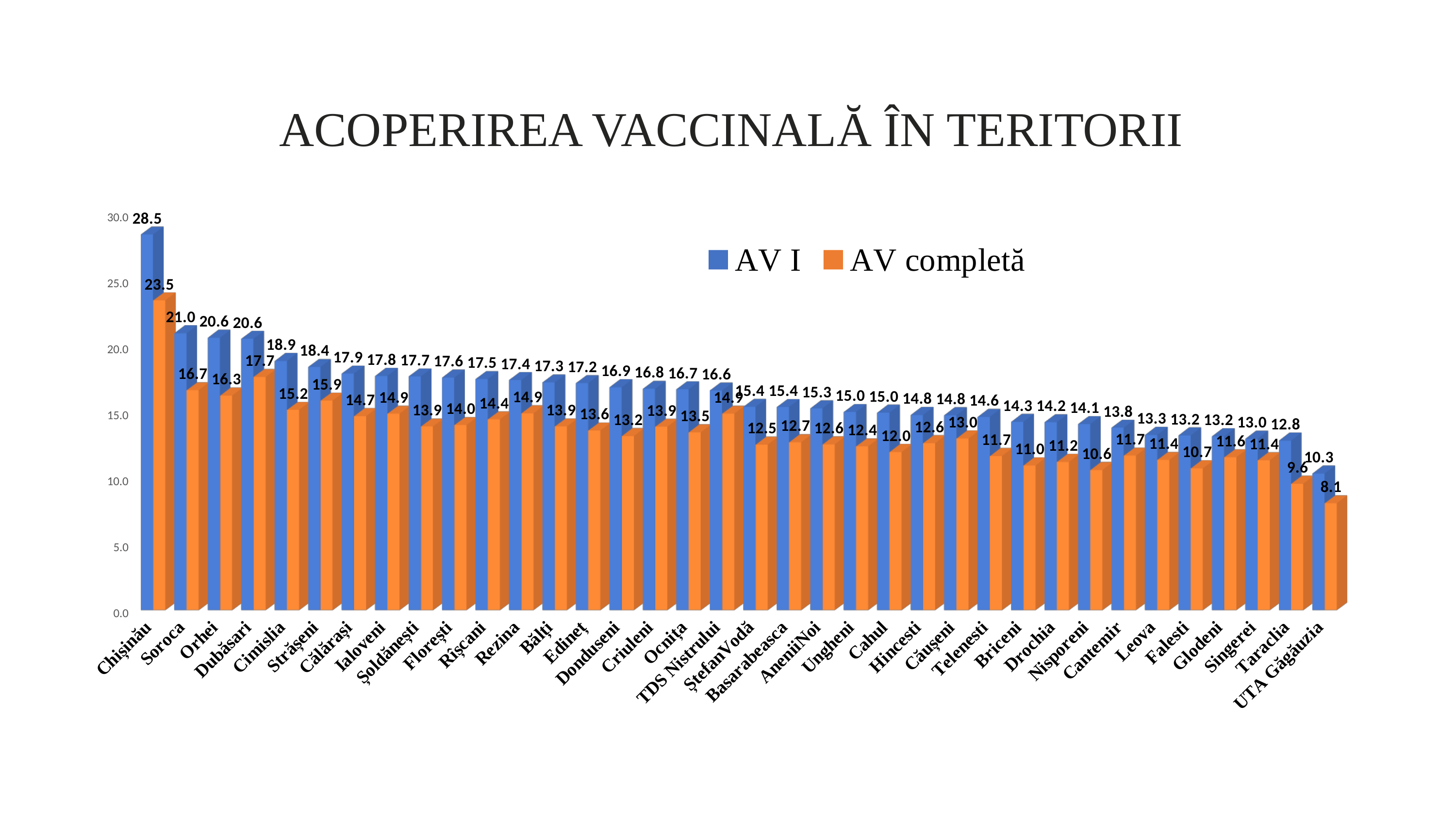
Which territory has the highest AV completă value? Chișinău Do the AV I values generally rise or fall from left to right along the x axis? fall Which territory has the lowest AV I value? UTA Găgăuzia How many series does the legend list? 2 What is the AV I value for Taraclia? 12.8 Which is larger: the AV completă value for Dubăsari or the AV completă value for Orhei? Dubăsari What is the difference between the AV I and AV completă values for Chișinău? 5.0 What is the AV I value for Chișinău? 28.5 Is the AV I value for Cimislia greater or less than 20.0? less How many territories are shown on the x axis? 36 What is the AV completă value for Soroca? 16.7 What kind of chart is shown on the slide? bar chart